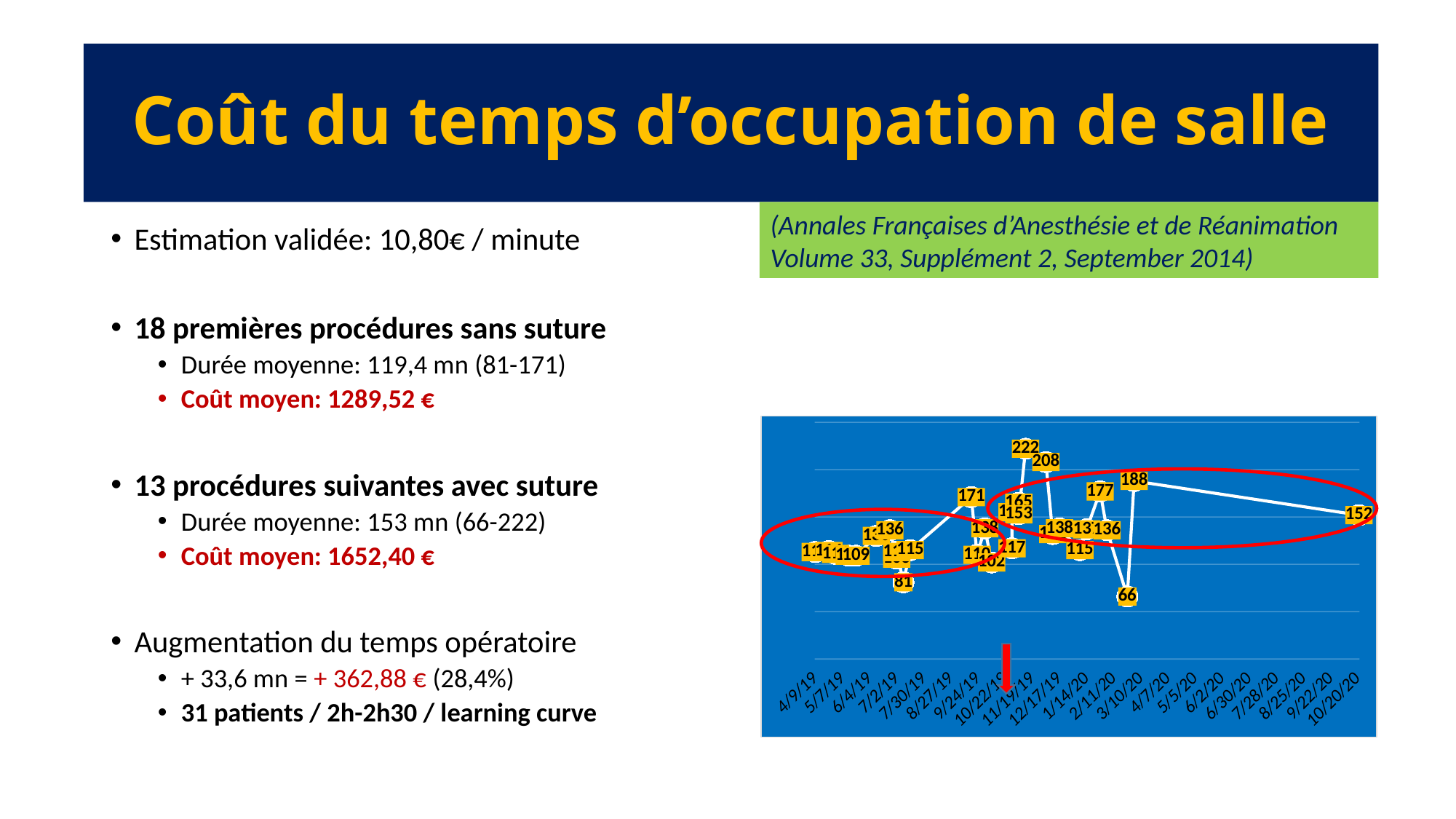
What is the difference between the points labelled 222 and 208? 14 What is the difference between the highest labelled value (222) and the lowest labelled value (66)? 156 How many red ellipses are drawn on the chart? 2 What is the lowest value labelled on the chart? 66 What kind of chart is shown on the slide? line chart What is the value of the last (rightmost) point on the chart? 152 Which is larger, the point labelled 208 or the point labelled 188? 208 Which is larger, the point labelled 81 or the point labelled 66? 81 What is the highest value labelled on the chart? 222 What colour is the background of the chart area? blue What is the difference between the points labelled 188 and 152? 36